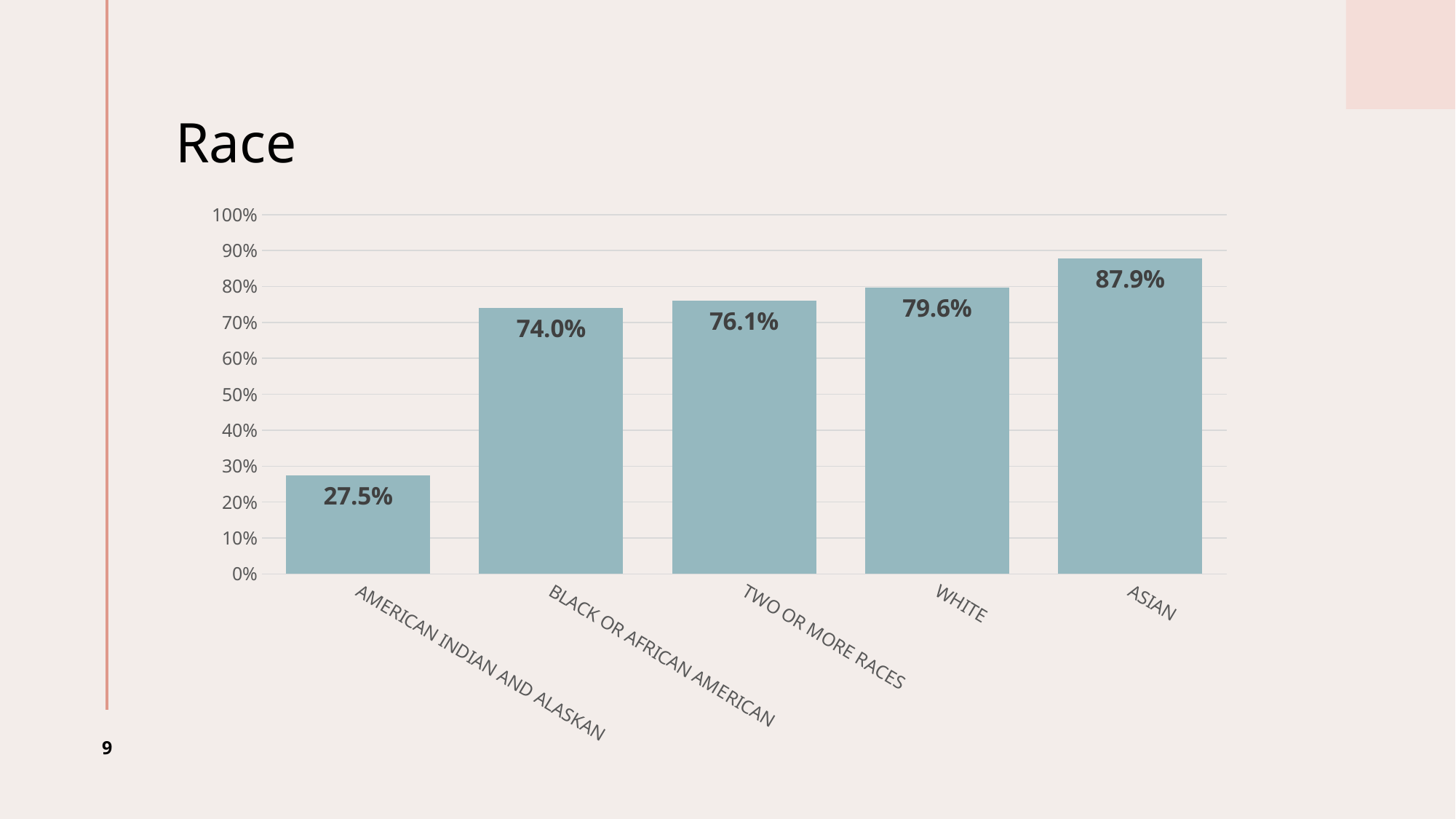
What is the value for White? 79.6% Is the value for Asian greater or less than 80%? greater How many categories are shown on the chart? 5 Which is larger, the value for Black or African American or the value for Two or More Races? Two or More Races What is the difference between the values for Asian and White? 8.3% What kind of chart is shown on the slide? Bar chart Which category has the highest value? Asian What is the value for Two or More Races? 76.1% What is the difference between the values for Black or African American and American Indian and Alaskan? 46.5% Which category has the lowest value? American Indian and Alaskan What is the title of the slide? Race What is the value for American Indian and Alaskan? 27.5%